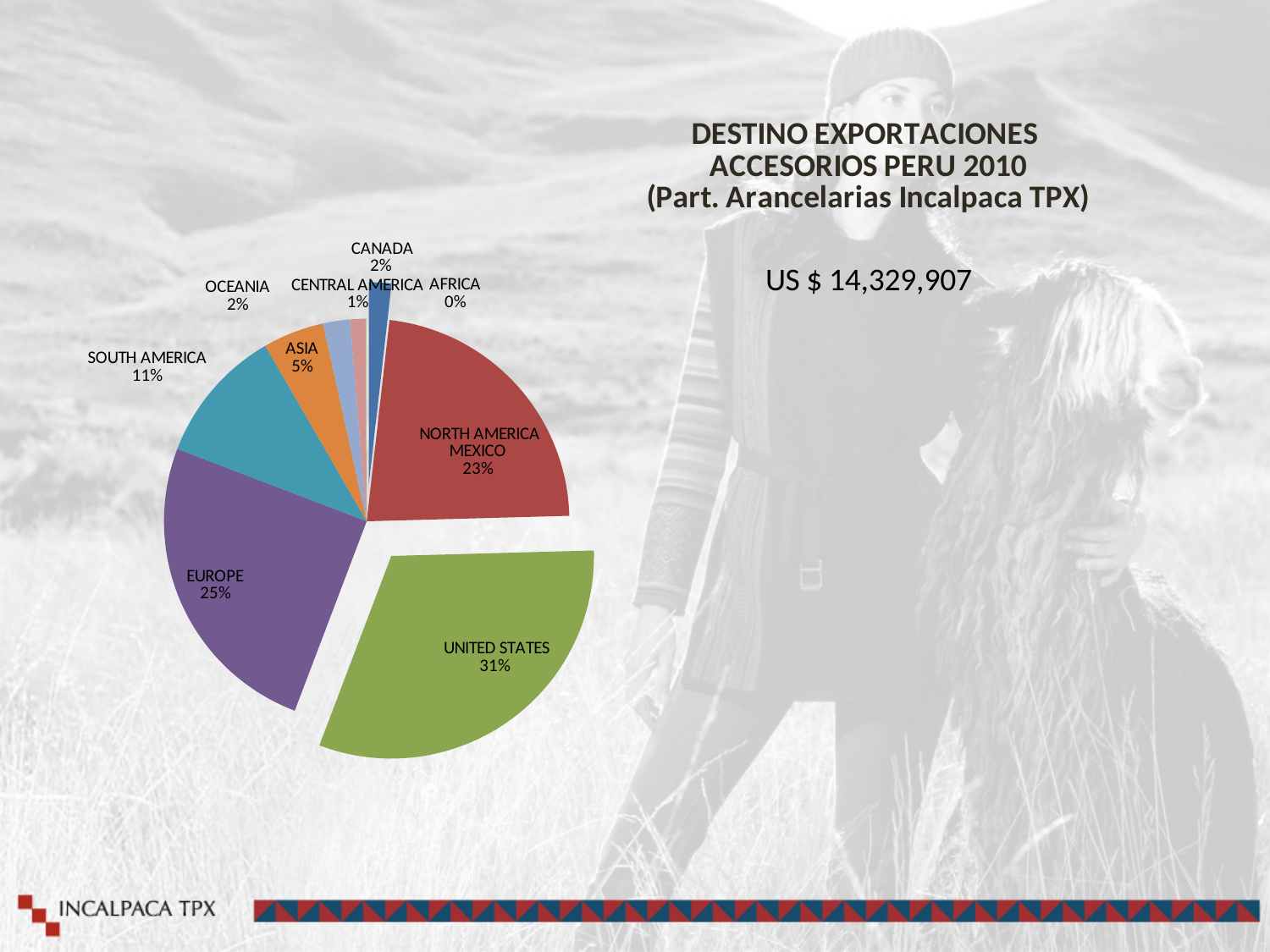
What is the value shown for ASIA? 5% How many categories are shown in the pie chart? 9 What is the value shown for NORTH AMERICA MEXICO? 23% What kind of chart is shown on the slide? Pie chart What is the value shown for SOUTH AMERICA? 11% Which category has the largest slice of the pie? UNITED STATES Which category has the smallest slice of the pie? AFRICA What is the difference between the shares of UNITED STATES and EUROPE? 6% What share of the pie does EUROPE hold? 25% Which is larger, the share for EUROPE or the share for NORTH AMERICA MEXICO? EUROPE What share of the pie does UNITED STATES hold? 31% What total export value is printed next to the chart? US $ 14,329,907